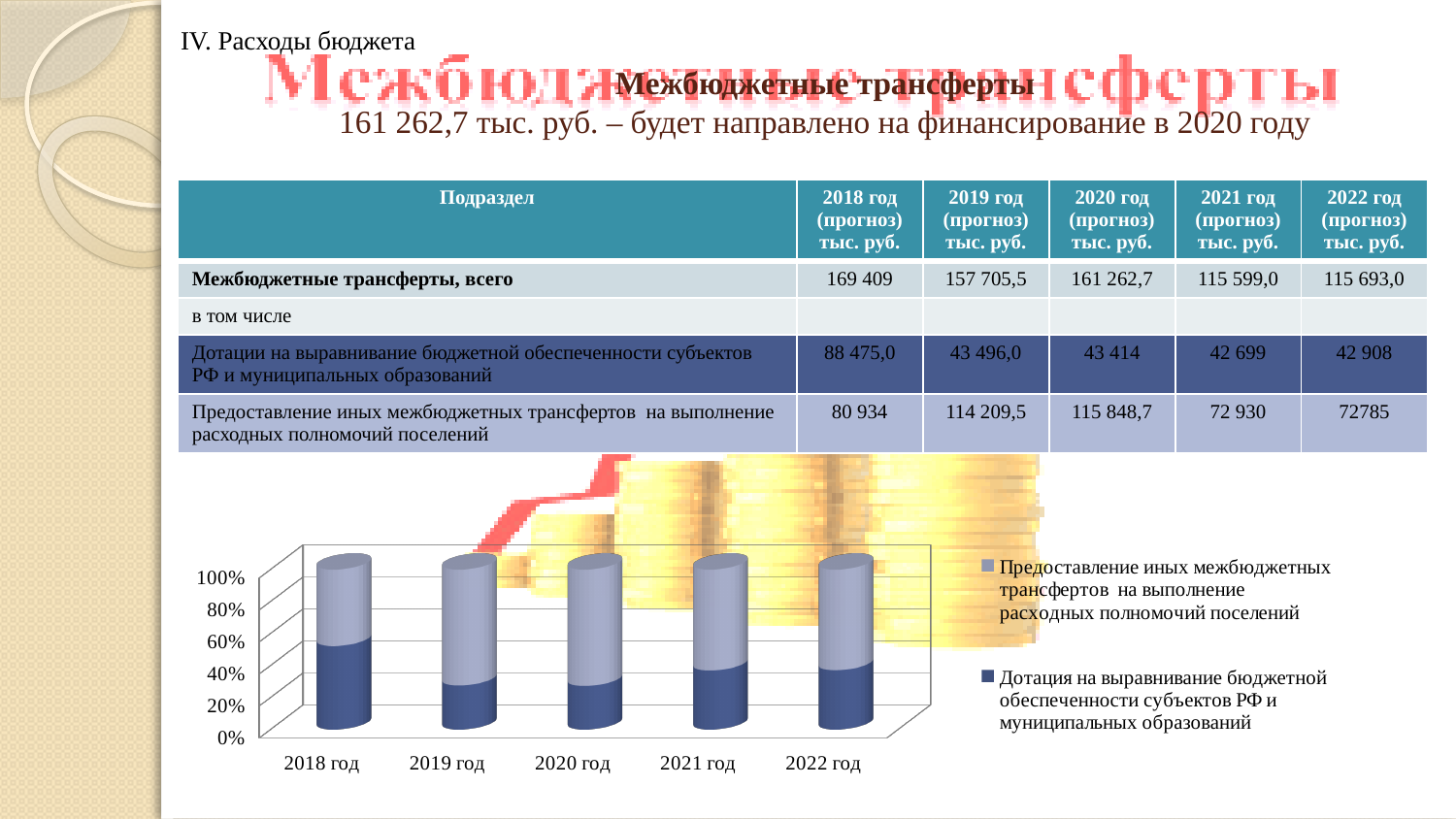
In the chart, is the share for «Дотация на выравнивание бюджетной обеспеченности» in 2018 год greater or less than 40%? greater How many years (categories) are shown on the x axis of the chart? 5 How many series does the chart legend list? 2 In the chart, which year has the larger share for «Дотация на выравнивание бюджетной обеспеченности»: 2018 год or 2019 год? 2018 год What kind of chart is shown on the slide? Stacked bar chart In the chart, is the share for «Дотация на выравнивание бюджетной обеспеченности» in 2019 год greater or less than 40%? less In the chart, is the share for «Дотация на выравнивание бюджетной обеспеченности» in 2020 год greater or less than 20%? greater In the chart, which year has the larger share for «Предоставление иных межбюджетных трансфертов»: 2020 год or 2018 год? 2020 год What is the highest tick value shown on the vertical axis of the chart? 100% Which series is shown in dark blue in the chart? Дотация на выравнивание бюджетной обеспеченности субъектов РФ и муниципальных образований Which year has the largest share for «Дотация на выравнивание бюджетной обеспеченности субъектов РФ и муниципальных образований» in the chart? 2018 год